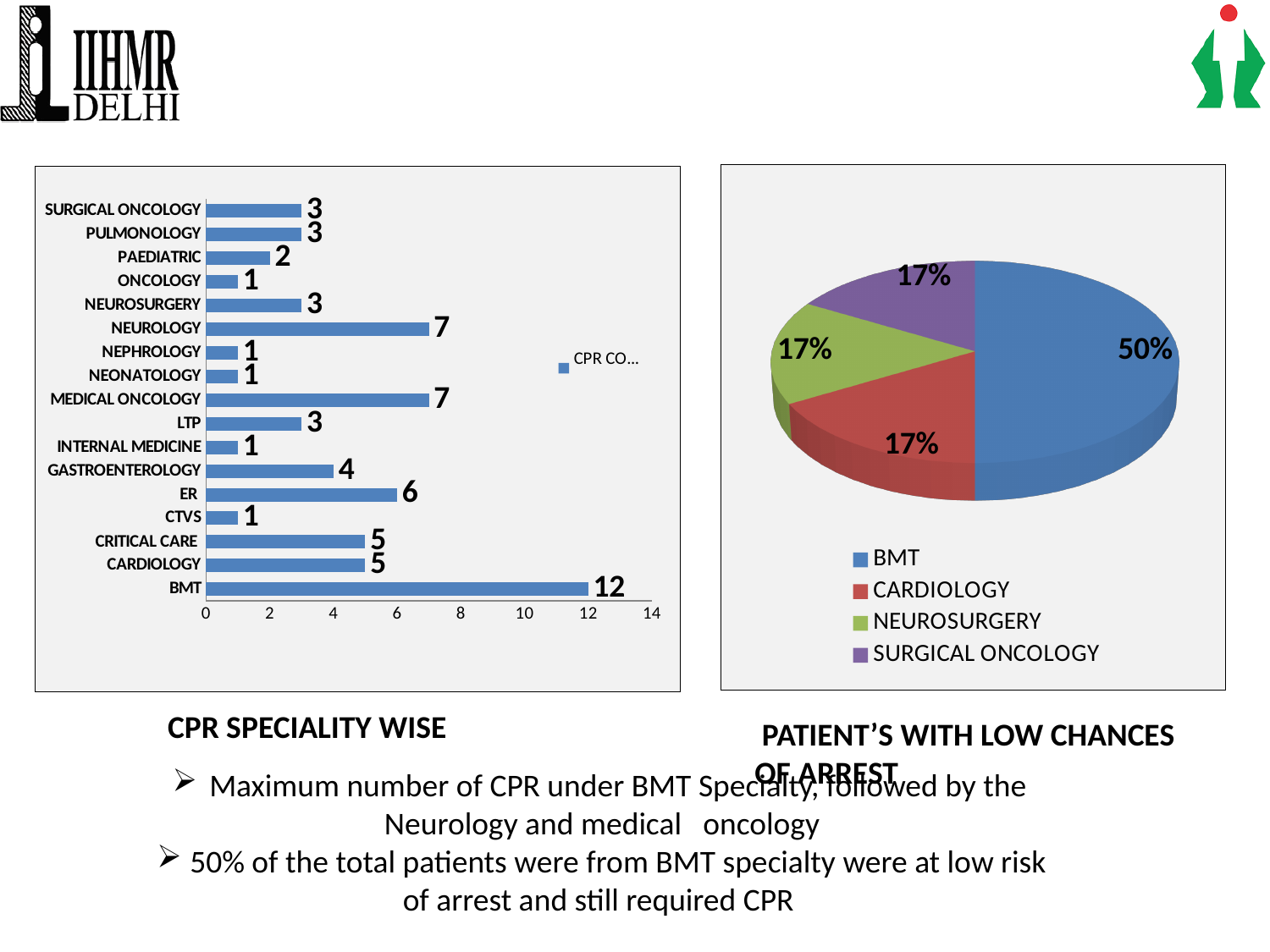
In the CPR SPECIALITY WISE bar chart, what is the value for NEUROLOGY? 7 In the PATIENT'S WITH LOW CHANCES OF ARREST pie chart, what share does BMT have? 50% In the CPR SPECIALITY WISE bar chart, which is larger, the value for CRITICAL CARE or the value for PAEDIATRIC? CRITICAL CARE How many slices does the PATIENT'S WITH LOW CHANCES OF ARREST pie chart have? 4 How many specialties are shown in the CPR SPECIALITY WISE bar chart? 17 In the CPR SPECIALITY WISE bar chart, which specialty has the highest value? BMT In the CPR SPECIALITY WISE bar chart, what is the value for BMT? 12 In the PATIENT'S WITH LOW CHANCES OF ARREST pie chart, what share does CARDIOLOGY have? 17% In the CPR SPECIALITY WISE bar chart, what is the value for GASTROENTEROLOGY? 4 In the PATIENT'S WITH LOW CHANCES OF ARREST pie chart, which category is shown in blue? BMT In the CPR SPECIALITY WISE bar chart, what is the difference between the values for BMT and ER? 6 What kind of chart is the CPR SPECIALITY WISE chart? Bar chart